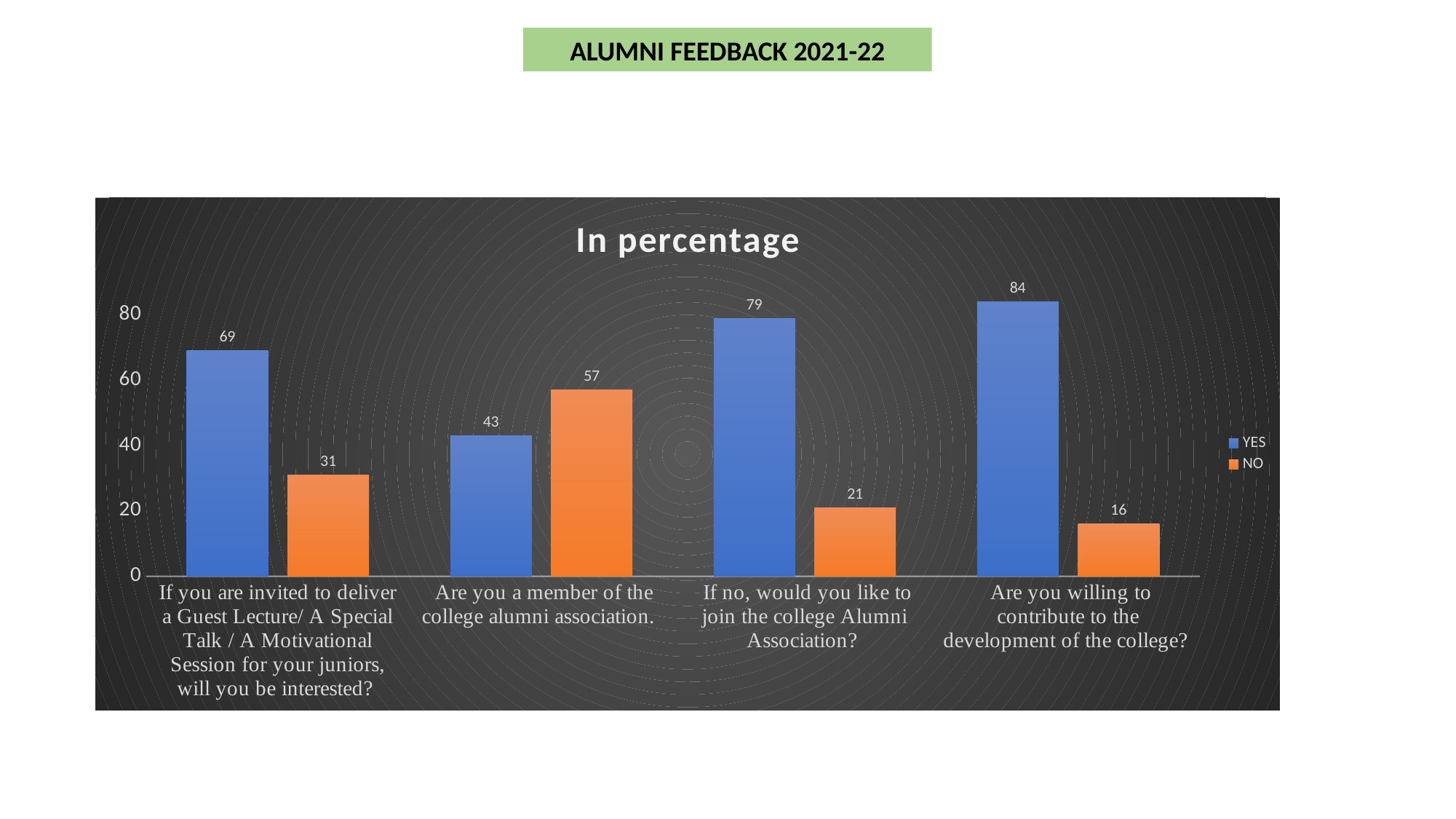
What is the NO value for "If no, would you like to join the college Alumni Association?" 21 What is the difference between the YES and NO values for the guest lecture question? 38 Which question has the lowest NO value? Are you willing to contribute to the development of the college? Is the YES value for "If no, would you like to join the college Alumni Association?" greater or less than 60? greater How many series does the legend list? 2 What is the NO value for "Are you a member of the college alumni association."? 57 What is the title of the chart? In percentage How many questions (categories) are shown on the x axis? 4 What is the YES value for "Are you willing to contribute to the development of the college?" 84 For "Are you a member of the college alumni association.", which is larger, YES or NO? NO What kind of chart is shown on the slide? Bar chart Which question has the highest YES value? Are you willing to contribute to the development of the college?